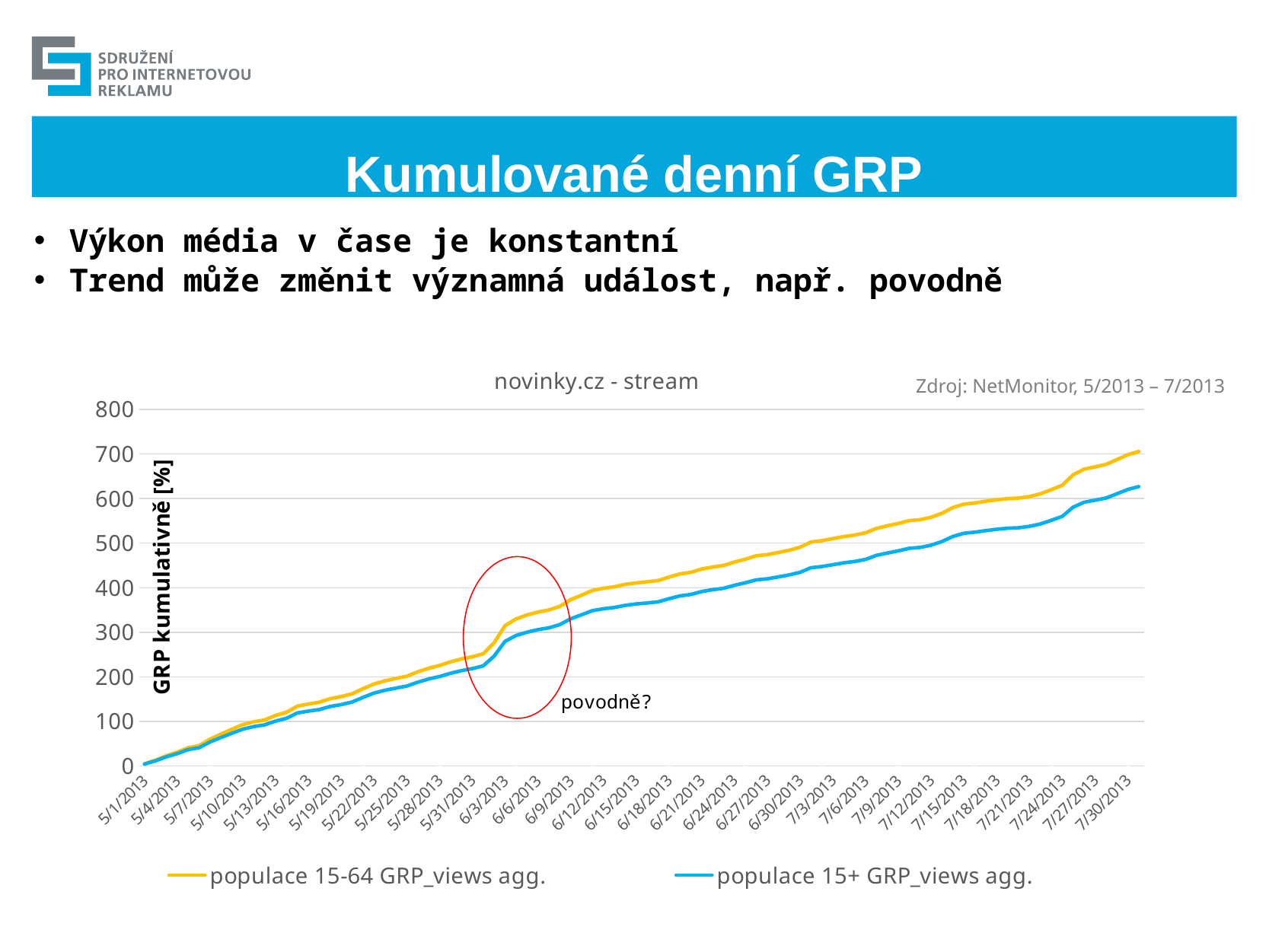
At 7/30/2013, which series has the higher value: 'populace 15-64 GRP_views agg.' or 'populace 15+ GRP_views agg.'? populace 15-64 GRP_views agg. Do the values of the 'populace 15+ GRP_views agg.' series rise or fall along the x axis? rise What is the label of the vertical axis of the chart? GRP kumulativně [%] What is the title of the chart? novinky.cz - stream Is the value of 'populace 15+ GRP_views agg.' at 6/30/2013 greater or less than 400? greater How many series does the chart legend list? 2 Is the value of 'populace 15-64 GRP_views agg.' at 7/30/2013 greater or less than 600? greater What kind of chart is shown on the slide? line chart Do the values of the 'populace 15-64 GRP_views agg.' series rise or fall along the x axis? rise Is the value of 'populace 15+ GRP_views agg.' at 7/30/2013 greater or less than 600? greater